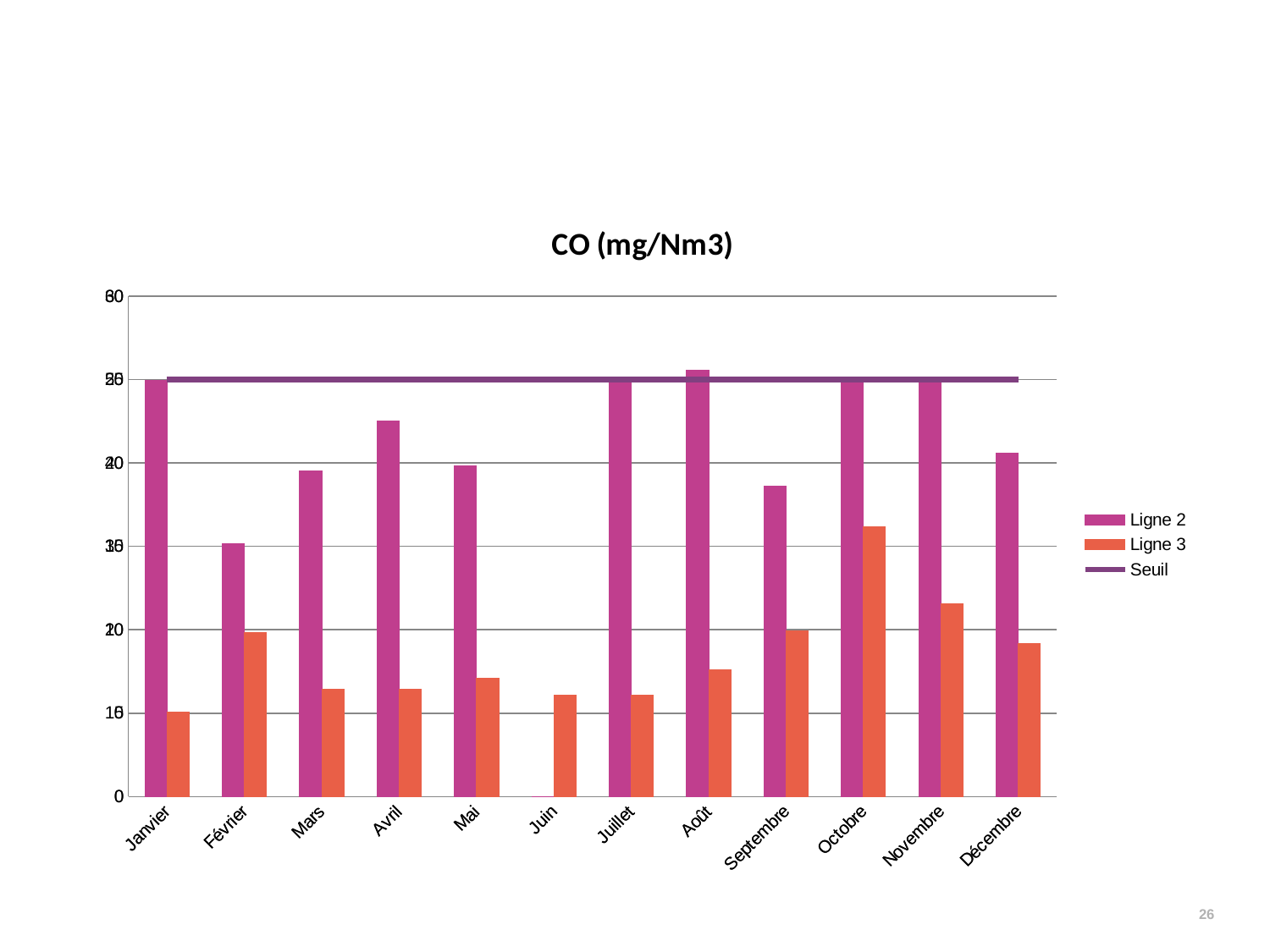
For Ligne 2, which is larger, Avril or Mars? Avril For Ligne 3, which is larger, Février or Mars? Février How many months are shown on the x axis? 12 For Ligne 3, which is larger, Novembre or Septembre? Novembre Which month has the highest value for Ligne 2? Août Which month has the highest value for Ligne 3? Octobre Which month has no bar for Ligne 2? Juin What kind of chart is shown on the slide? combination bar and line chart What is the title of the chart? CO (mg/Nm3) Which month has the lowest value for Ligne 3? Janvier How many entries does the legend list? 3